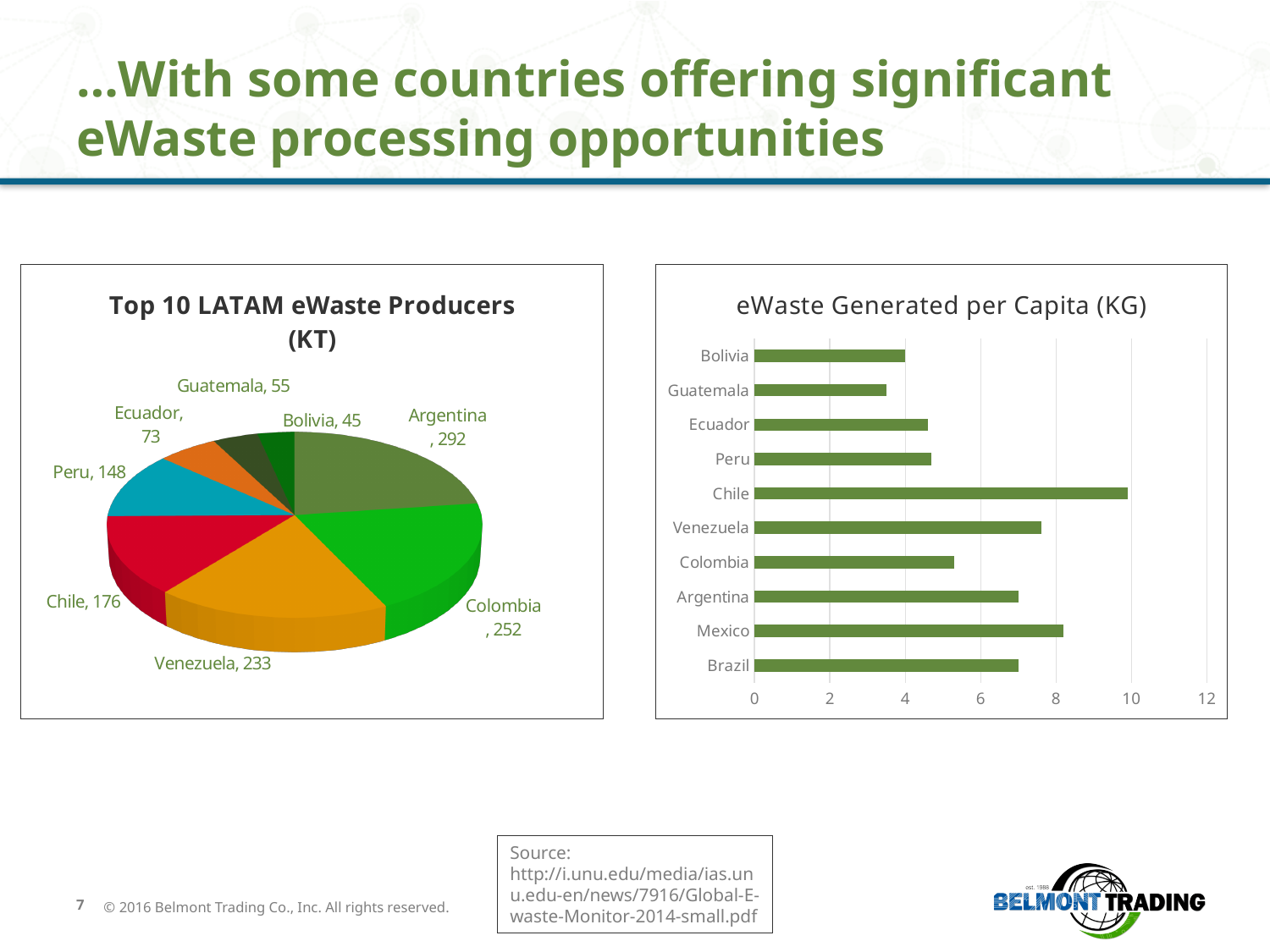
In the 'Top 10 LATAM eWaste Producers (KT)' chart, what is the value for Venezuela? 233 In the 'eWaste Generated per Capita (KG)' chart, which country has the highest value? Chile How many countries are shown in the 'eWaste Generated per Capita (KG)' chart? 10 In the 'Top 10 LATAM eWaste Producers (KT)' chart, what is the difference between Argentina and Colombia? 40 In the 'Top 10 LATAM eWaste Producers (KT)' chart, what is the value for Argentina? 292 In the 'eWaste Generated per Capita (KG)' chart, is the value for Venezuela greater or less than 6? greater In the 'Top 10 LATAM eWaste Producers (KT)' chart, which is larger, Chile or Venezuela? Venezuela In the 'Top 10 LATAM eWaste Producers (KT)' chart, which labelled country has the smallest value? Bolivia In the 'Top 10 LATAM eWaste Producers (KT)' chart, what is the value for Bolivia? 45 What kind of chart is the 'Top 10 LATAM eWaste Producers (KT)' chart? Pie chart In the 'eWaste Generated per Capita (KG)' chart, which country has the lowest value? Guatemala In the 'Top 10 LATAM eWaste Producers (KT)' chart, what is the value for Peru? 148